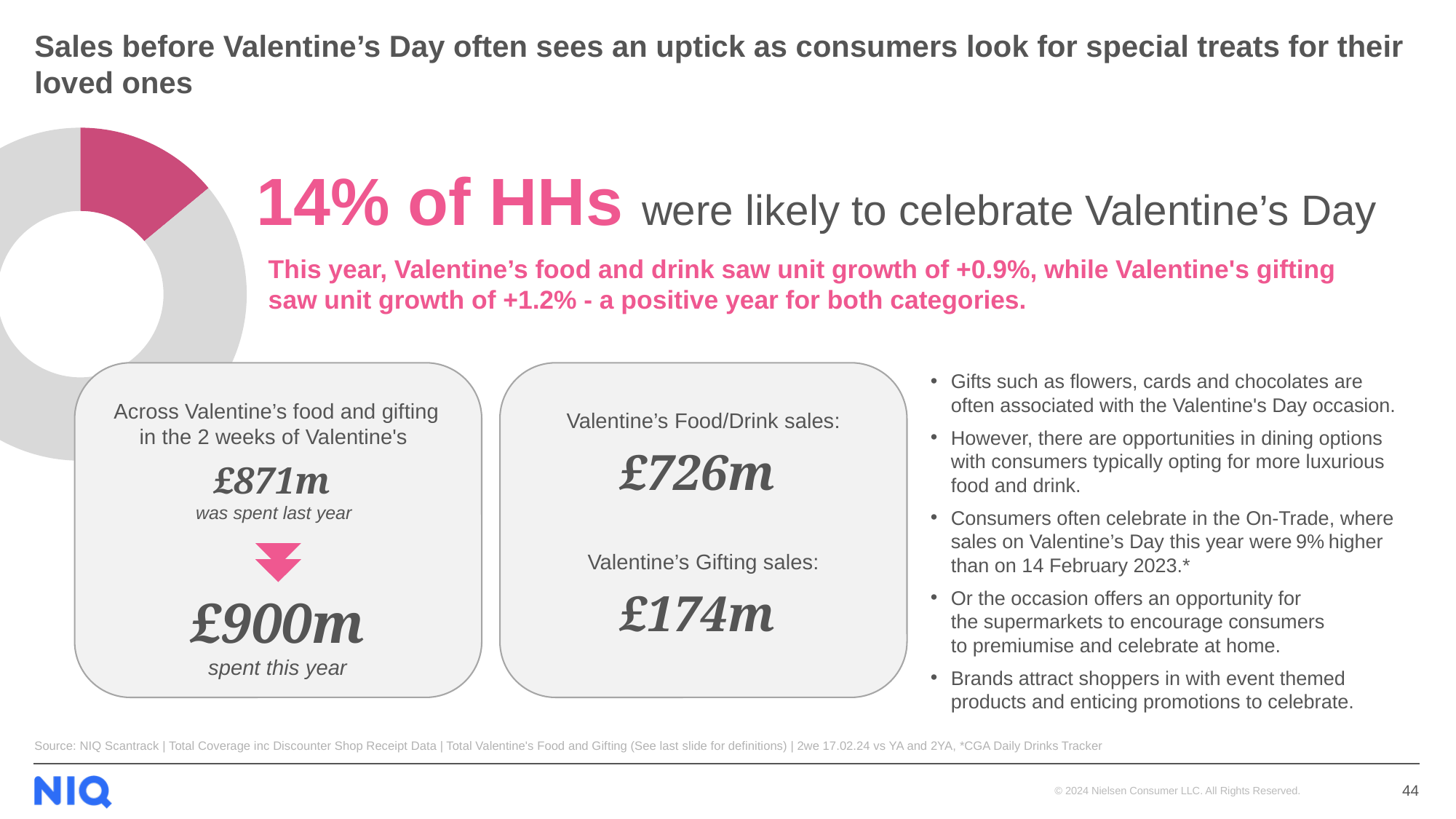
In the donut chart, which slice is larger, the pink slice or the grey slice? The grey slice What share of households does the pink slice of the donut chart represent? 14% What colour is the slice of the donut chart that represents households likely to celebrate Valentine's Day? Pink Is the share shown by the pink slice of the donut chart greater or less than 50%? less What kind of chart is shown on the left of the slide? Donut chart How many slices does the donut chart have? 2 What does the highlighted 14% slice of the donut chart represent? Households likely to celebrate Valentine's Day